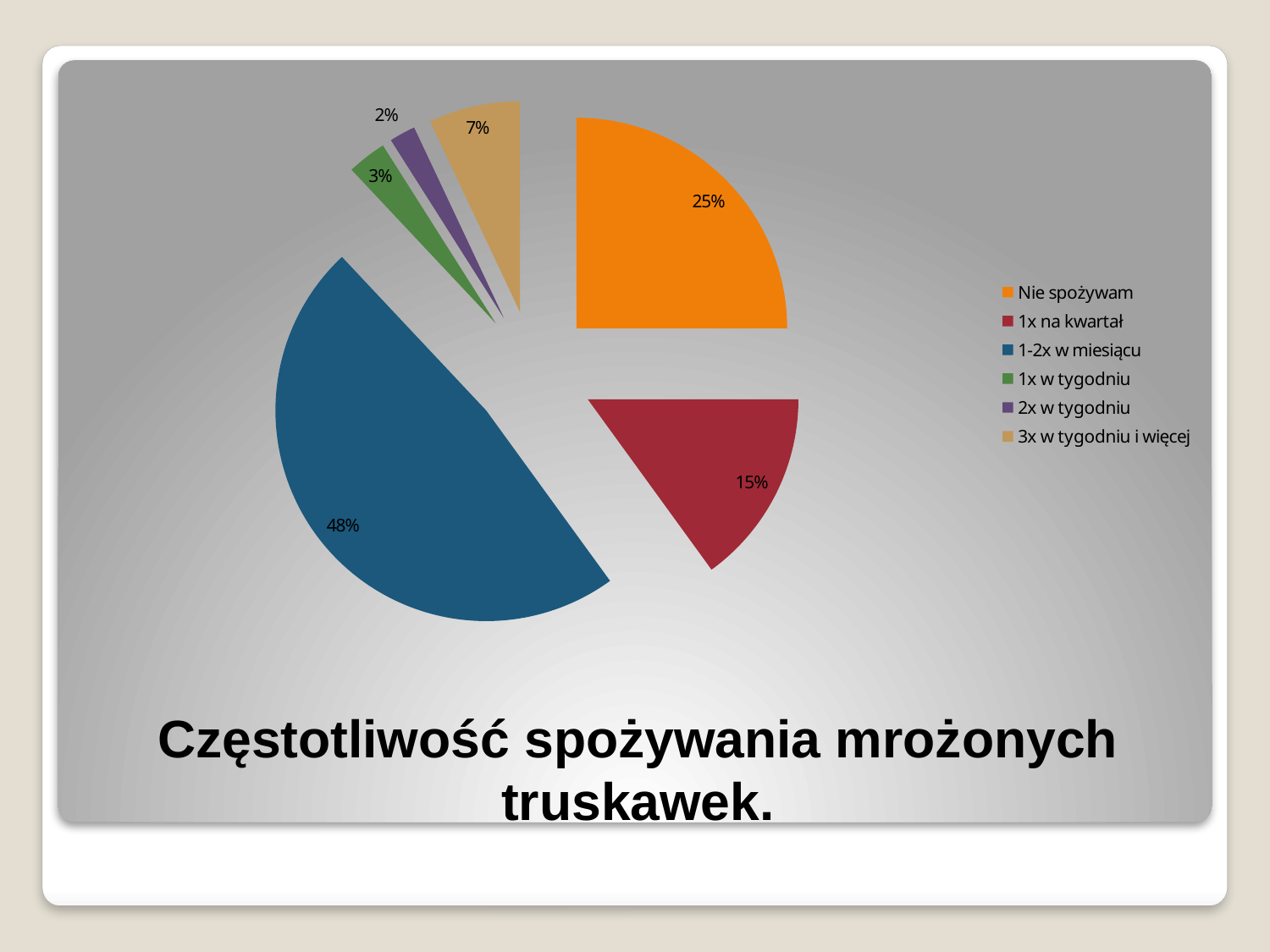
Which category has the smallest slice of the pie? 2x w tygodniu What share of the pie is labelled for "1-2x w miesiącu"? 48% How many categories does the legend list? 6 Which category has the largest slice of the pie? 1-2x w miesiącu What share of the pie is labelled for "1x na kwartał"? 15% What is the difference in percentage points between "1-2x w miesiącu" and "Nie spożywam"? 23 What share of the pie is labelled for "2x w tygodniu"? 2% Which is larger, the slice for "1x w tygodniu" or the slice for "3x w tygodniu i więcej"? 3x w tygodniu i więcej What kind of chart is shown on the slide? pie chart What is the title shown on the slide? Częstotliwość spożywania mrożonych truskawek.